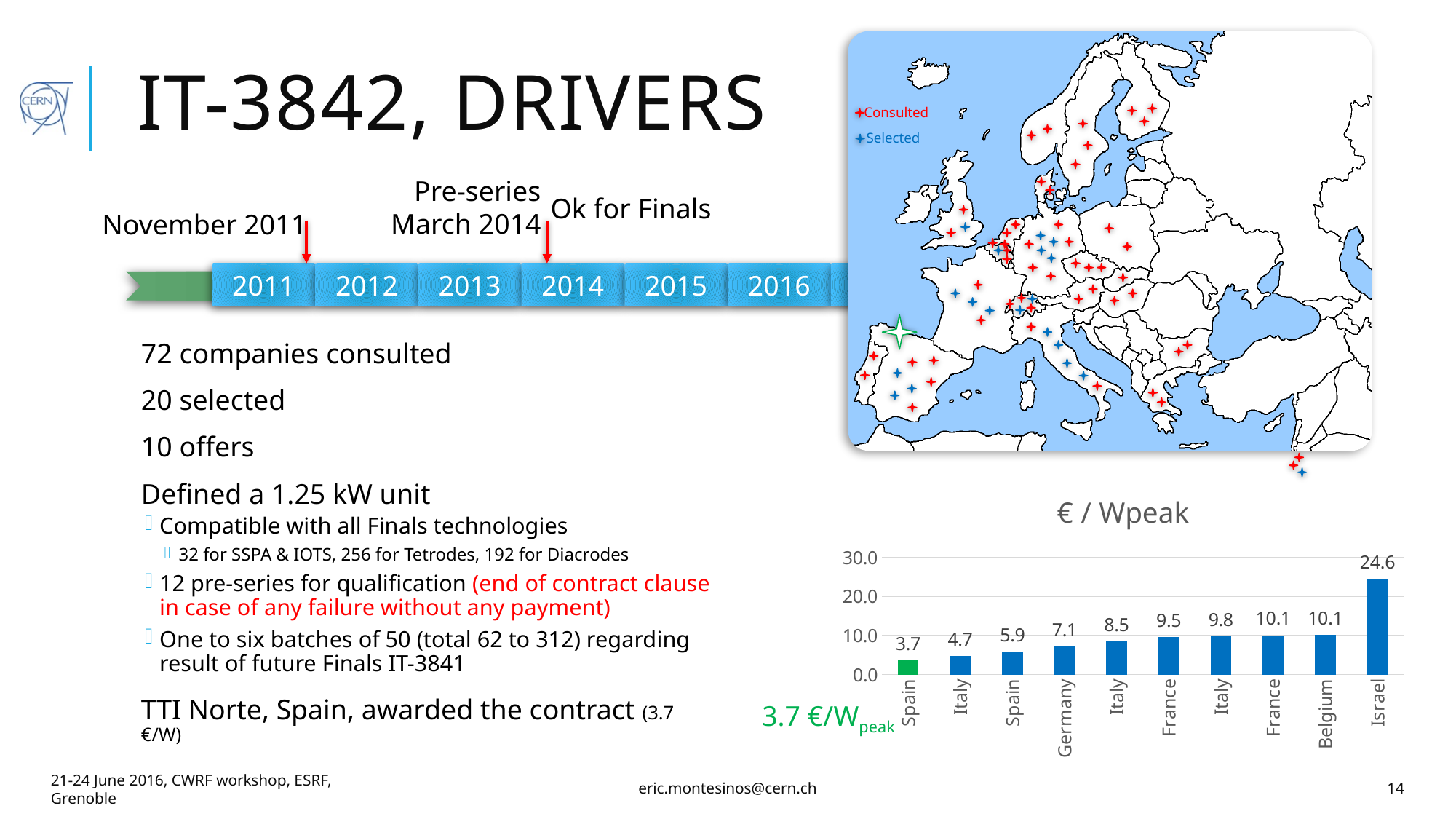
In the "€ / Wpeak" chart, what is the value for Israel? 24.6 In the "€ / Wpeak" chart, what is the value for Germany? 7.1 In the "€ / Wpeak" chart, what is the value of the leftmost (green) bar? 3.7 How many bars are plotted in the "€ / Wpeak" chart? 10 In the "€ / Wpeak" chart, which category has the lowest value? Spain In the "€ / Wpeak" chart, which category has the highest value? Israel In the "€ / Wpeak" chart, what is the value for Belgium? 10.1 In the "€ / Wpeak" chart, do the values rise or fall from left to right along the x axis? rise In the "€ / Wpeak" chart, is the value for Israel greater or less than 20.0? greater What kind of chart is the "€ / Wpeak" chart? bar chart In the "€ / Wpeak" chart, what is the difference between the values for Israel and Belgium? 14.5 In the "€ / Wpeak" chart, which is larger, the value for Germany or the value for Belgium? Belgium